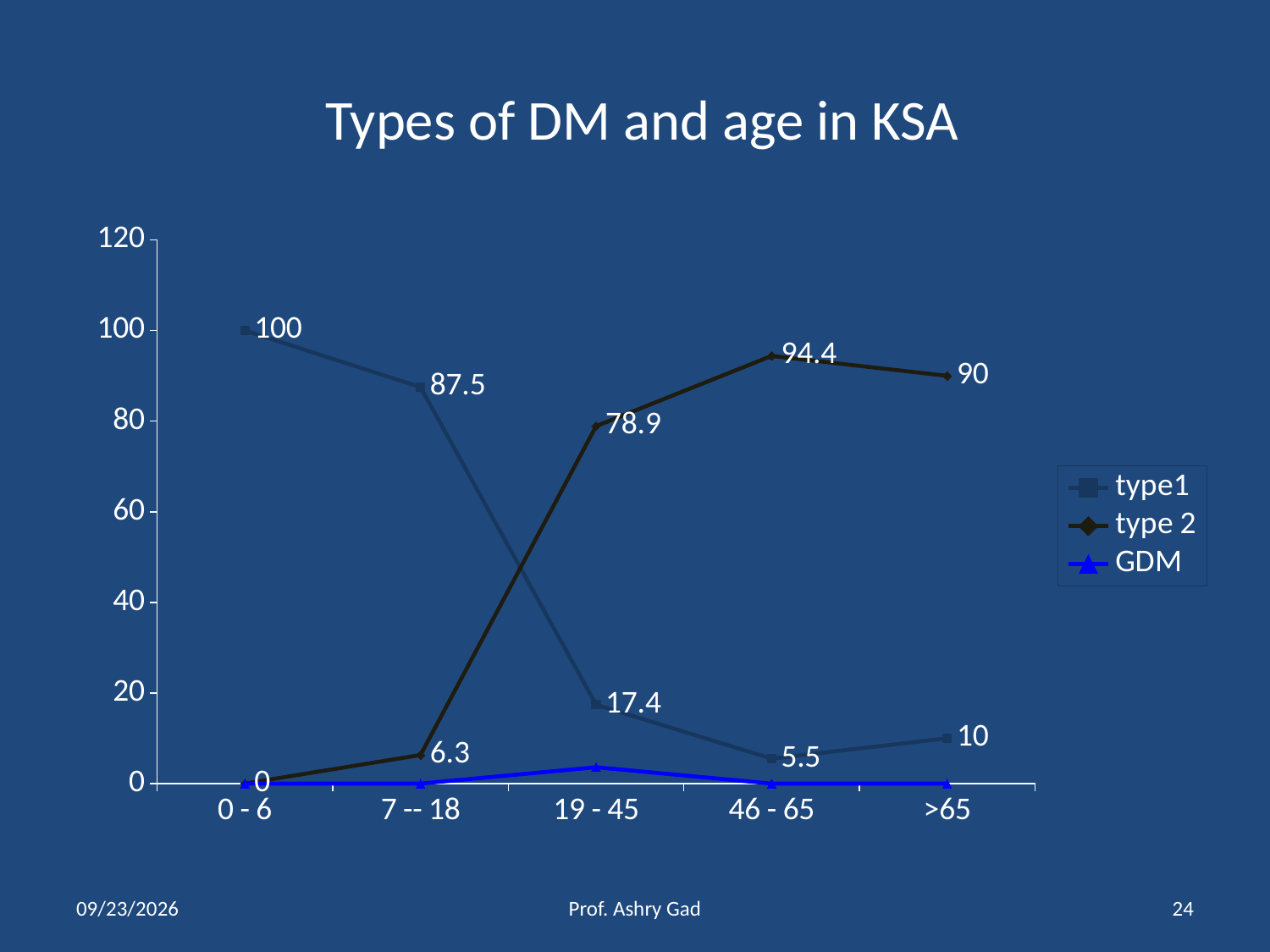
What is the value for type 2 in the 46 - 65 age group? 94.4 How many age groups are shown on the x axis? 5 What kind of chart is shown on the slide? line chart In which age group is the type1 value lowest? 46 - 65 How many series does the legend list? 3 What is the value for type1 in the 0 - 6 age group? 100 In the 19 - 45 age group, which is larger, type1 or type 2? type 2 Is the GDM value for 19 - 45 greater or less than 20? less What is the difference between the type1 values for 0 - 6 and 7 -- 18? 12.5 What is the value for type1 in the >65 age group? 10 What is the value for type 2 in the 19 - 45 age group? 78.9 In which age group is the type 2 value highest? 46 - 65